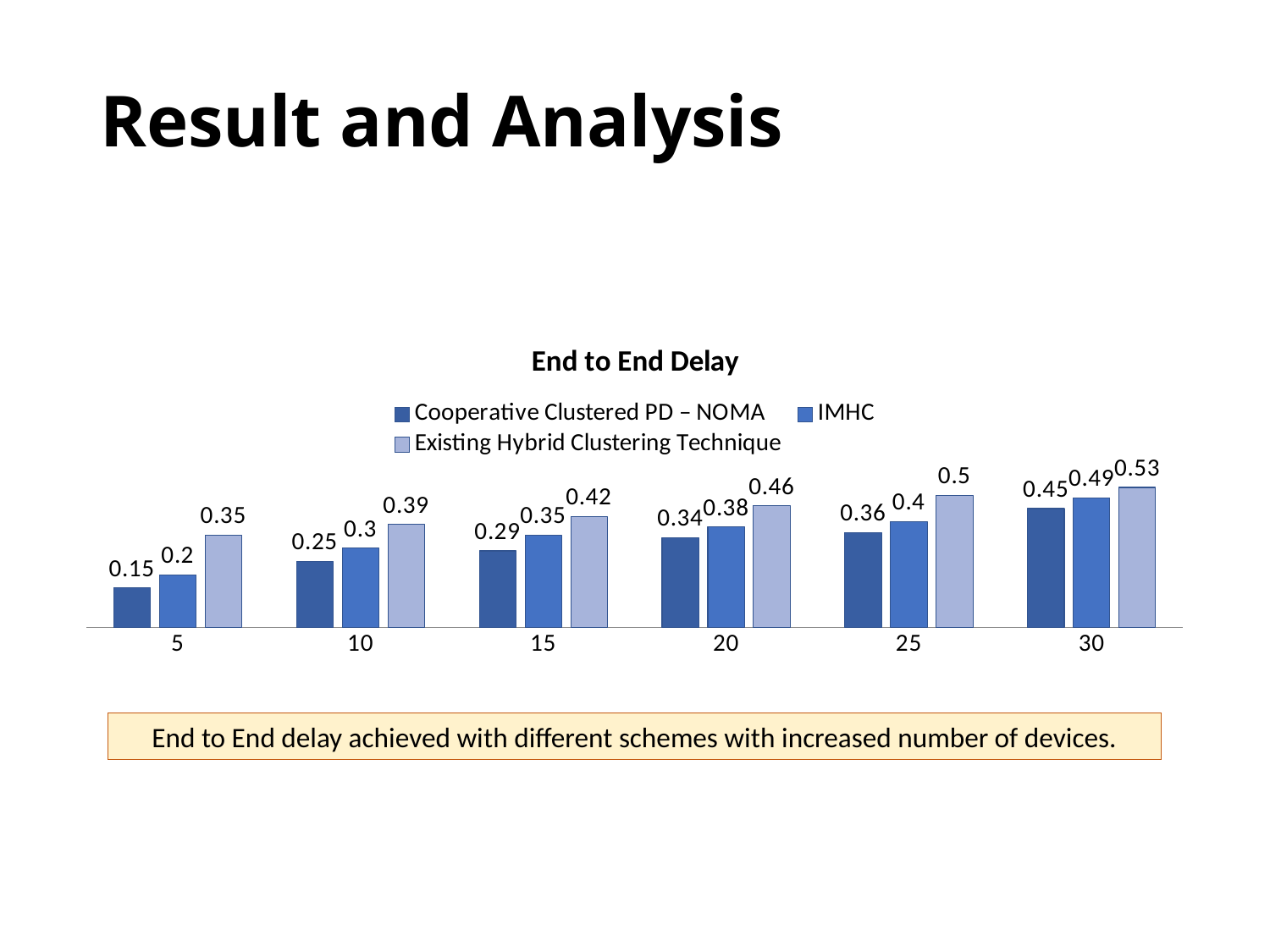
What is the title of the chart on the slide? End to End Delay How many series does the legend of the End to End Delay chart list? 3 Which series has the larger value at 15 devices, IMHC or Cooperative Clustered PD – NOMA? IMHC At which x-axis category does the Existing Hybrid Clustering Technique series reach its highest value? 30 What is the End to End Delay value for Cooperative Clustered PD – NOMA at 5 devices? 0.15 At which x-axis category does the Cooperative Clustered PD – NOMA series have its lowest value? 5 What is the End to End Delay value for Existing Hybrid Clustering Technique at 30 devices? 0.53 What is the End to End Delay value for IMHC at 20 devices? 0.38 Do the IMHC values rise or fall as the number of devices increases along the x axis? rise What is the difference between the Existing Hybrid Clustering Technique value and the Cooperative Clustered PD – NOMA value at 25 devices? 0.14 How many categories are shown on the x axis of the End to End Delay chart? 6 What kind of chart is the End to End Delay chart? bar chart